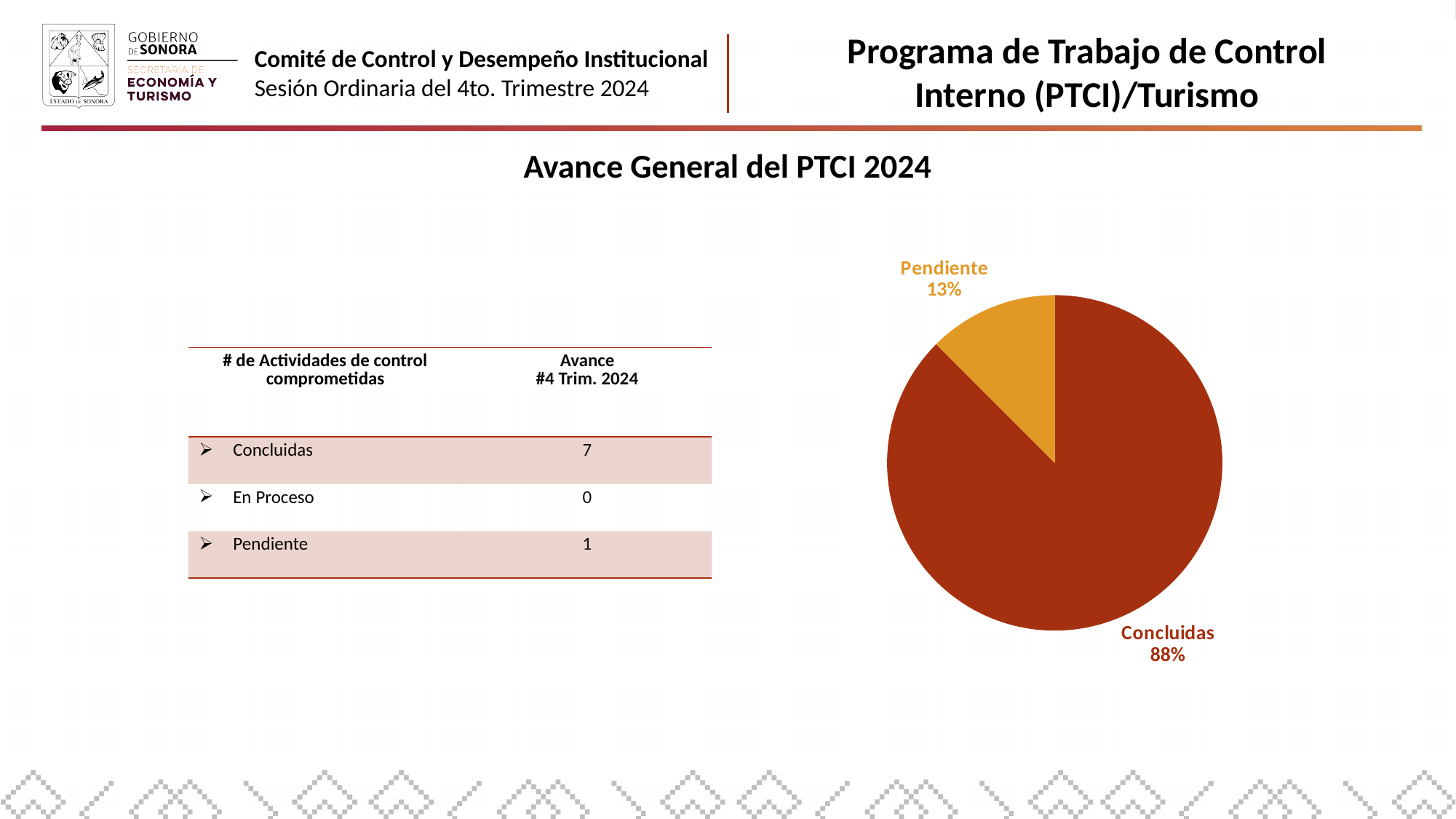
Is the share for Concluidas in the pie chart greater or less than 50%? greater What is the heading above the pie chart on the slide? Avance General del PTCI 2024 What kind of chart is shown on the slide? Pie chart What share of the pie chart does Concluidas represent? 88% Which slice of the pie chart is the largest? Concluidas What is the difference in percentage points between the Concluidas and Pendiente slices? 75 Which is larger in the pie chart, Concluidas or Pendiente? Concluidas What share of the pie chart does Pendiente represent? 13% How many slices does the pie chart have? 2 What colour is the Pendiente slice of the pie chart? Orange Which slice of the pie chart is the smallest? Pendiente